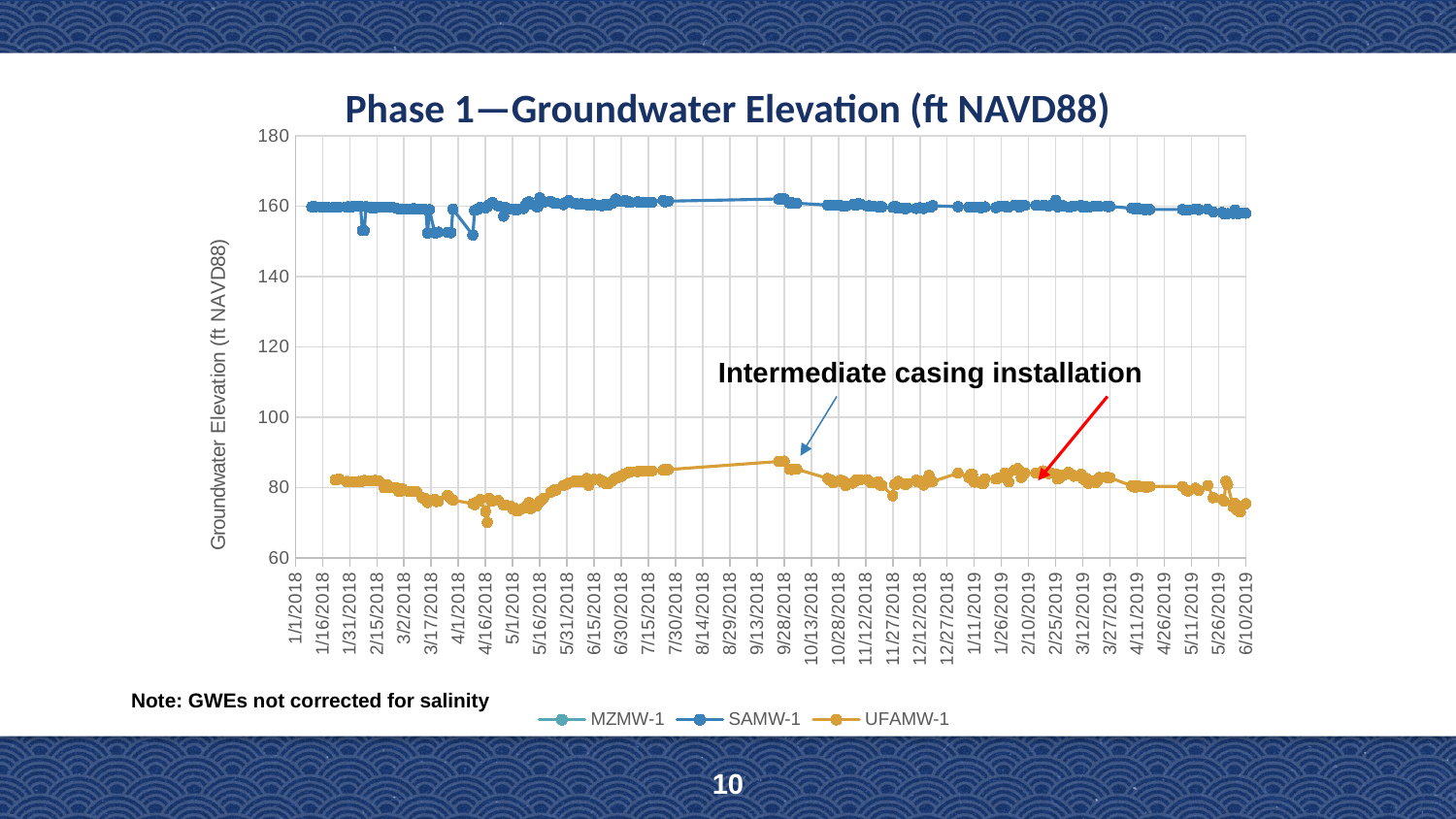
Is the value for UFAMW-1 on 5/1/2018 greater or less than 80? less What is the label on the vertical axis? Groundwater Elevation (ft NAVD88) How many series does the legend list? 3 Is the value for SAMW-1 on 6/10/2019 greater or less than 180? less Is the value for SAMW-1 on 1/1/2018 greater or less than 140? greater What kind of chart is shown on the slide? Line chart Do the UFAMW-1 values rise or fall between 5/1/2018 and 9/28/2018? rise Which plotted series has the highest groundwater elevation values throughout the chart? SAMW-1 Do the UFAMW-1 values rise or fall between 9/28/2018 and 6/10/2019? fall What is the title of the chart? Phase 1—Groundwater Elevation (ft NAVD88) Which series has the larger value on 1/1/2018, SAMW-1 or UFAMW-1? SAMW-1